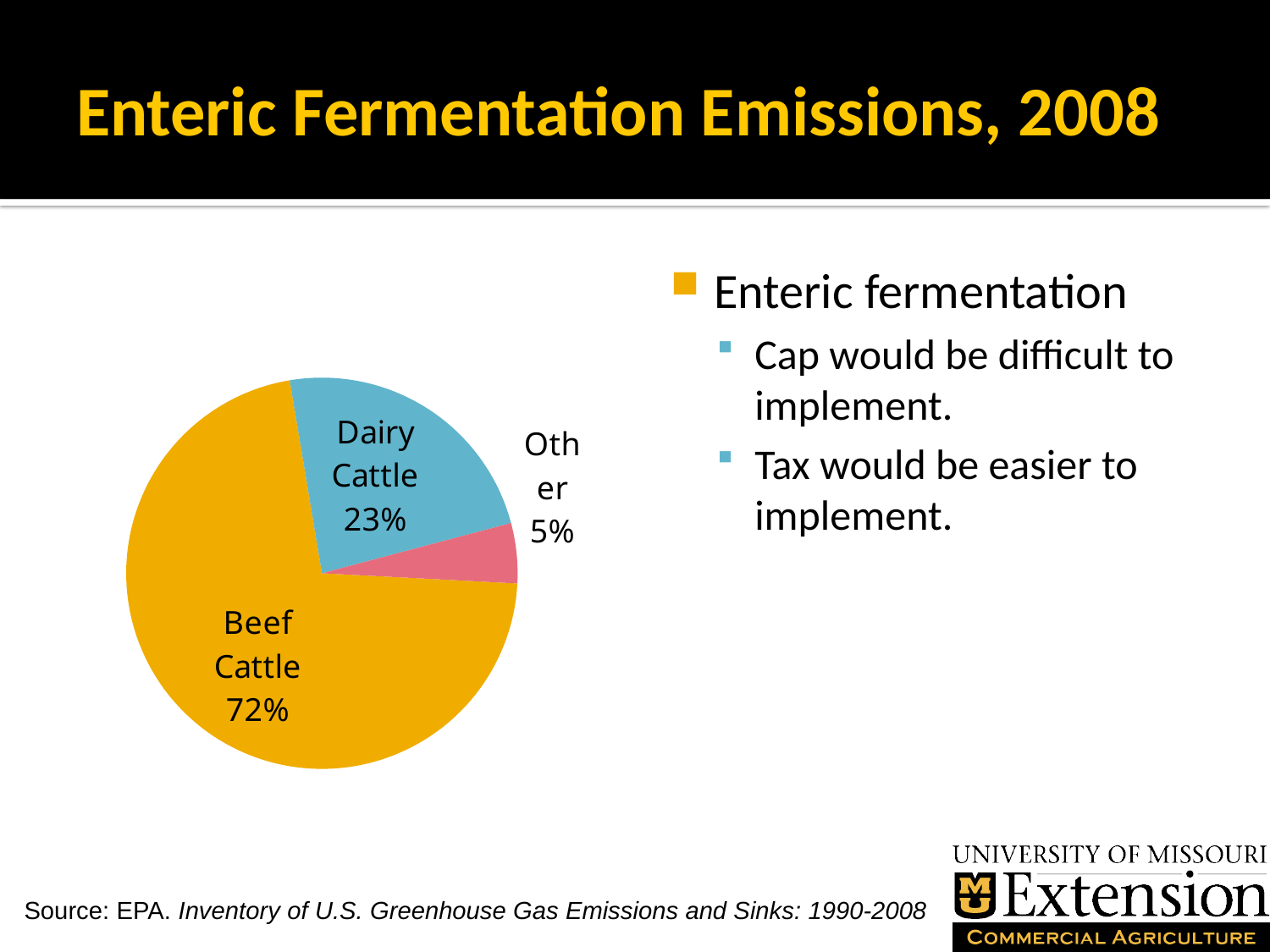
How many slices does the pie chart have? 3 What share of enteric fermentation emissions comes from Other? 5% What is the difference in percentage points between the Beef Cattle and Dairy Cattle shares? 49 Which category has the smallest share of the pie? Other What is the difference in percentage points between the Dairy Cattle and Other shares? 18 Which is larger, the Dairy Cattle share or the Other share? Dairy Cattle What kind of chart is shown on the slide? pie chart What share of enteric fermentation emissions comes from Beef Cattle? 72% What colour is the Beef Cattle slice? yellow What share of enteric fermentation emissions comes from Dairy Cattle? 23% Which category has the largest share of the pie? Beef Cattle What is the title of the chart slide? Enteric Fermentation Emissions, 2008